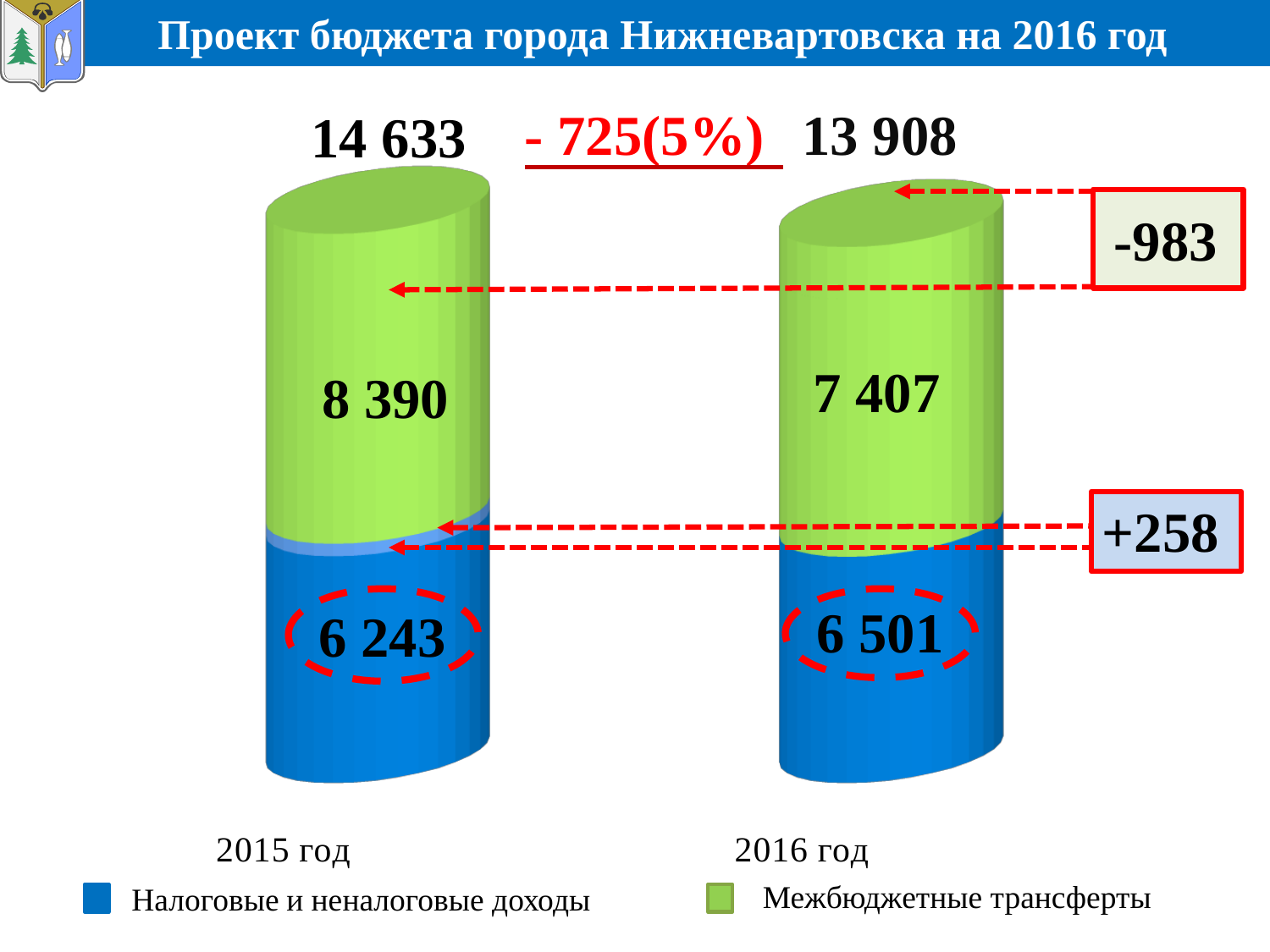
How many series does the legend list? 2 What is the total of the stacked bar for 2016 год? 13 908 What is the value of Налоговые и неналоговые доходы for 2015 год? 6 243 What is the total of the stacked bar for 2015 год? 14 633 By how much does Межбюджетные трансферты change from 2015 год to 2016 год? -983 Which year has the larger total budget, 2015 год or 2016 год? 2015 год What is the value of Межбюджетные трансферты for 2016 год? 7 407 By how much does Налоговые и неналоговые доходы change from 2015 год to 2016 год? +258 Which series is larger in 2016 год, Налоговые и неналоговые доходы or Межбюджетные трансферты? Межбюджетные трансферты What kind of chart is shown on the slide? Stacked bar chart What is the value of Налоговые и неналоговые доходы for 2016 год? 6 501 What is the value of Межбюджетные трансферты for 2015 год? 8 390